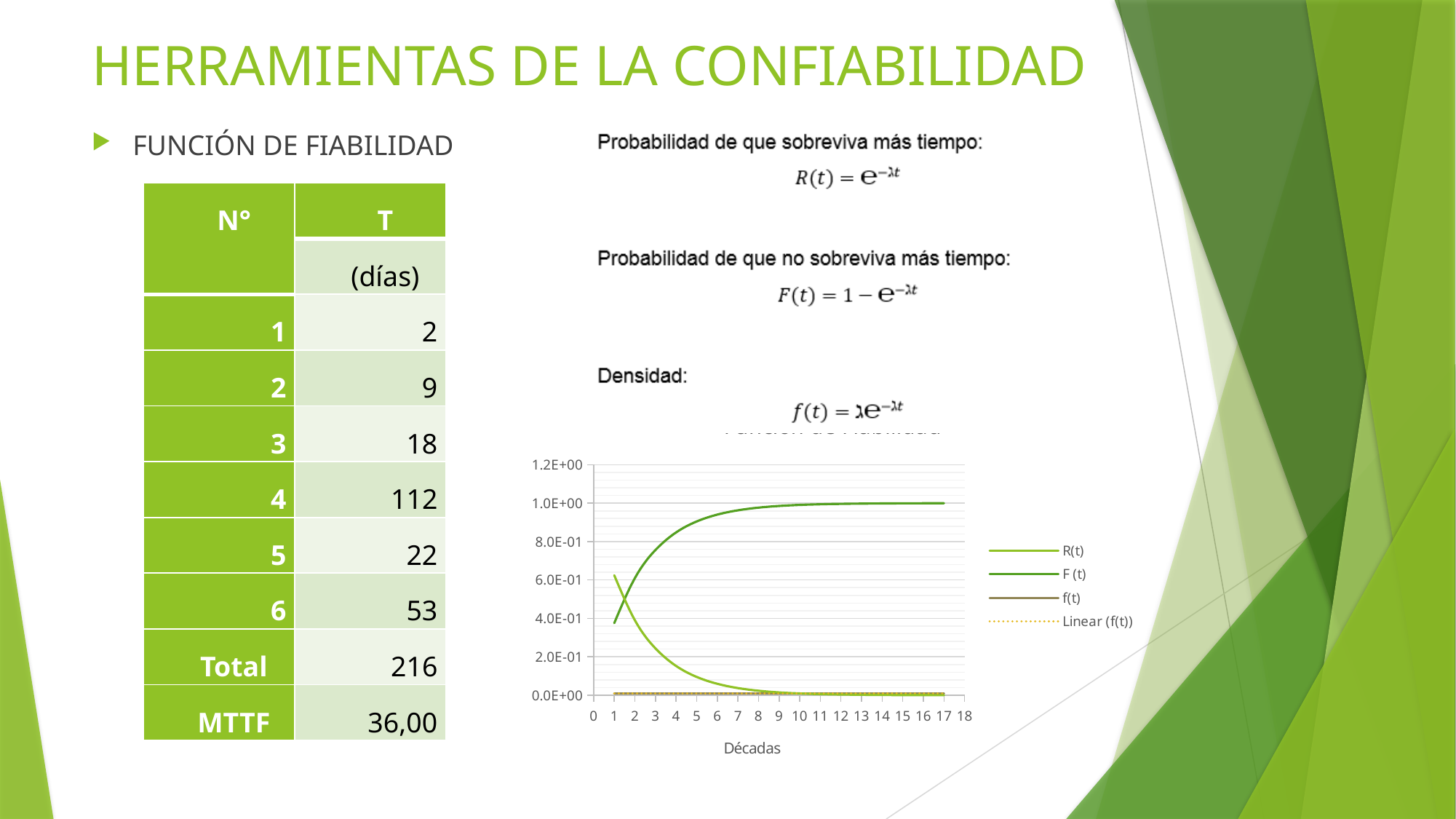
What is the label of the x axis of the chart? Décadas At decade 5, which series has the larger value, R(t) or F (t)? F (t) At decade 1, which series has the larger value, R(t) or F (t)? R(t) Does the R(t) series rise or fall as the decades increase along the x axis? fall How many series does the chart legend list? 4 What kind of chart is shown on the slide? line chart Is the value of R(t) at decade 10 greater or less than 2.0E-01? less Is the value of F (t) at decade 1 greater or less than 6.0E-01? less Is the value of R(t) at decade 1 greater or less than 4.0E-01? greater Which legend entry is drawn with a dotted line? Linear (f(t)) Does the F (t) series rise or fall as the decades increase along the x axis? rise